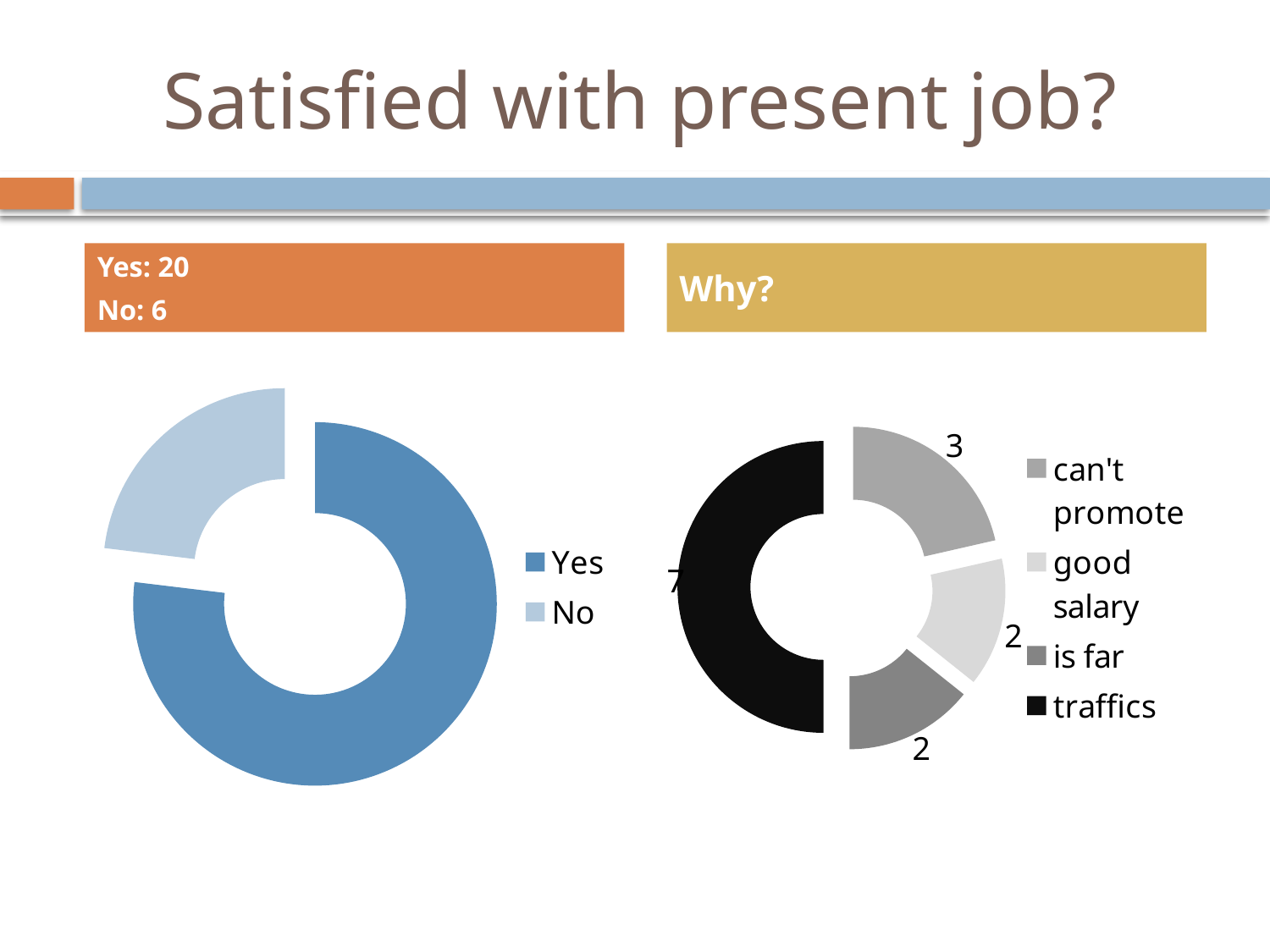
On the left chart, what is the value for Yes? 20 On the left chart, what is the value for No? 6 On the right chart (Why?), what is the value for traffics? 7 On the right chart (Why?), what is the value for can't promote? 3 On the right chart (Why?), how many categories does the legend list? 4 On the right chart (Why?), which category has the highest value? traffics On the right chart (Why?), what colour is the traffics slice? Black On the left chart, which category is larger, Yes or No? Yes How many series does the legend of the left chart list? 2 What kind of chart is the left chart? Doughnut chart On the left chart, what is the difference between the Yes and No values? 14 On the right chart (Why?), what is the difference between the values for traffics and can't promote? 4